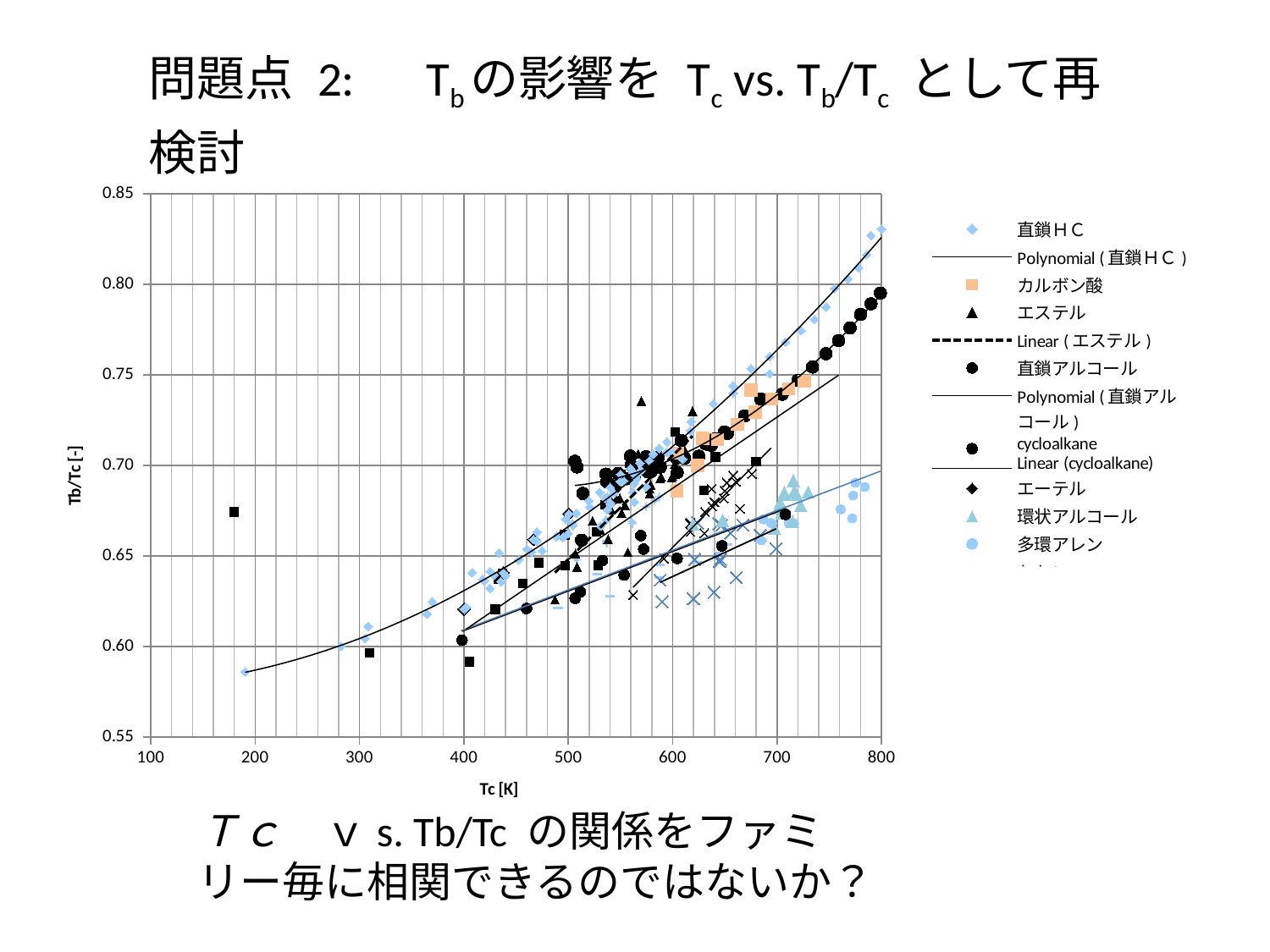
What kind of chart is shown on the slide? scatter chart Is the Tb/Tc value of the highest 直鎖ＨＣ point near Tc = 800 K greater or less than 0.80? greater What is the label of the y axis of the chart? Tb/Tc [-] Do the 直鎖ＨＣ values rise or fall as Tc increases along the x axis? rise Is the Tb/Tc value of the 直鎖アルコール point at Tc = 800 K greater or less than 0.75? greater Do the 直鎖アルコール values rise or fall as Tc increases from 600 K to 800 K? rise What is the maximum value shown on the y axis of the chart? 0.85 Is the Tb/Tc value of the lowest 直鎖ＨＣ point near Tc = 190 K greater or less than 0.60? less What is the label of the x axis of the chart? Tc [K]